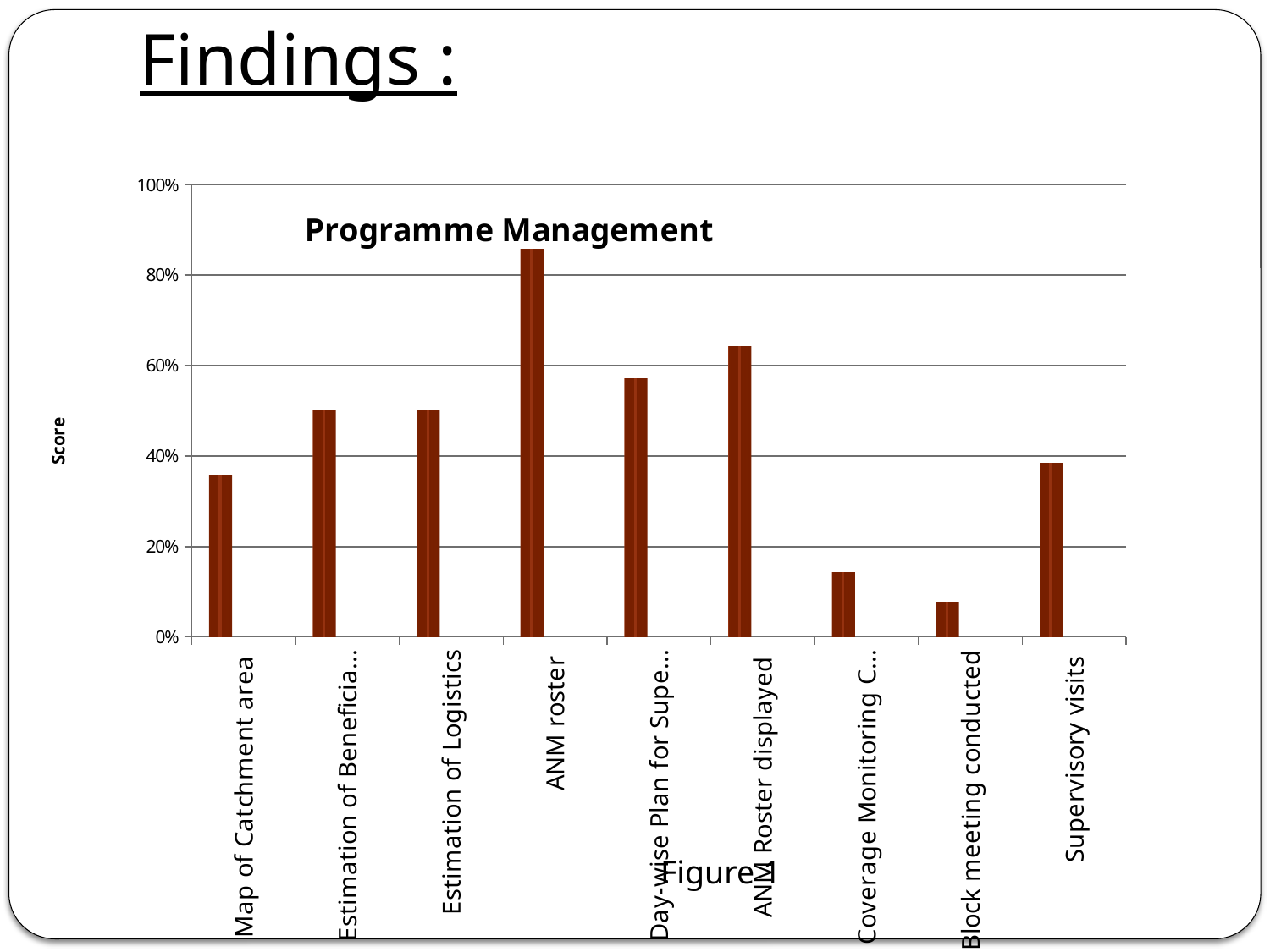
Which has a lower score, Block meeting conducted or Estimation of Logistics? Block meeting conducted What is the label on the vertical axis of the chart? Score Which category has the lowest score in the chart? Block meeting conducted Is the value for ANM Roster displayed greater or less than 60%? greater Which has a higher score, ANM Roster displayed or Supervisory visits? ANM Roster displayed What is the title of the chart? Programme Management How many categories are plotted in the chart? 9 Is the value for Block meeting conducted greater or less than 20%? less Which category has the highest score in the chart? ANM roster Is the value for ANM roster greater or less than 80%? greater What type of chart is shown on the slide? Bar chart